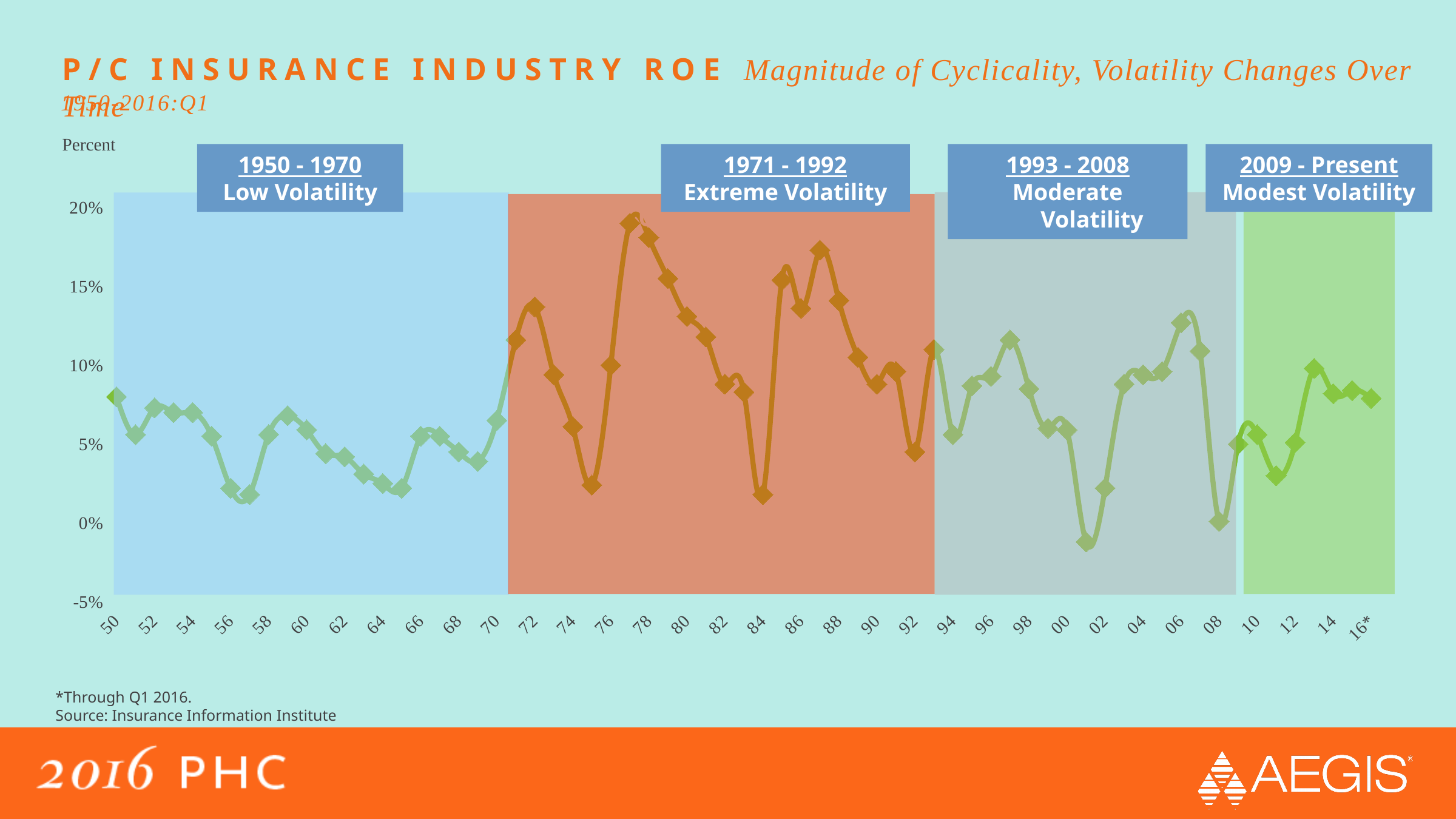
How many volatility periods are shaded on the chart? 4 Is the ROE value for 2001 greater or less than 0%? less What kind of chart is shown on the slide? line chart Is the ROE value for 1977 greater or less than 15%? greater Which volatility period label covers 1971 - 1992? Extreme Volatility Is the ROE value for 1984 greater or less than 5%? less Does the ROE rise or fall from 2008 to 2010? rise Which year has the highest P/C insurance industry ROE on the chart? 1977 Which year has the lowest P/C insurance industry ROE on the chart? 2001 Which year has the larger ROE, 1977 or 1975? 1977